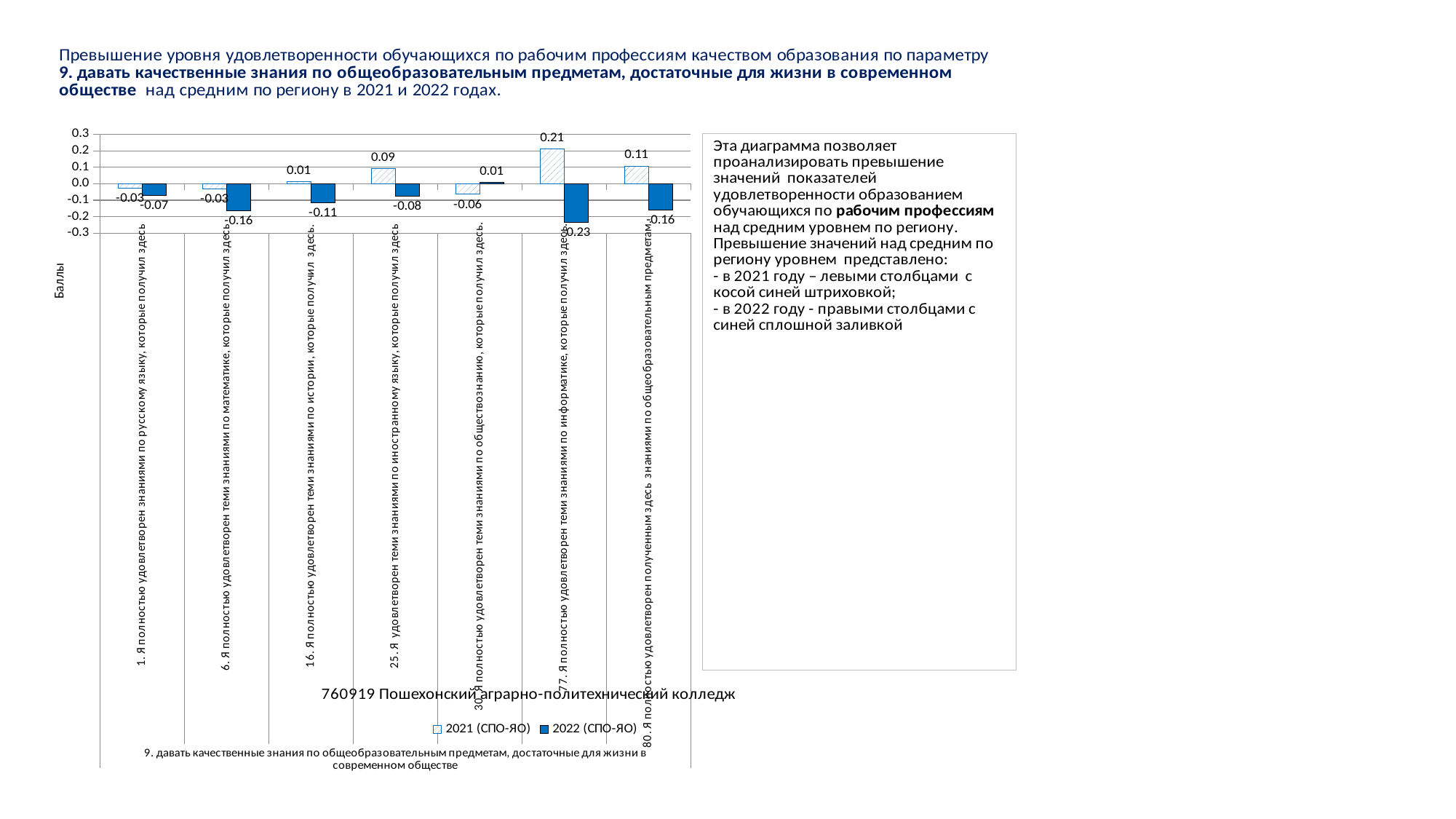
What is the 2022 (СПО-ЯО) value for category 30 (знания по обществознанию)? 0.01 How many categories are plotted on the x axis? 7 What is the label of the y axis? Баллы What is the difference between the 2021 and 2022 values for category 25 (знания по иностранному языку)? 0.17 Which category has the highest 2021 (СПО-ЯО) value? 77. Я полностью удовлетворен теми знаниями по информатике What is the 2021 (СПО-ЯО) value for category 80 (знания по общеобразовательным предметам)? 0.11 What is the 2021 (СПО-ЯО) value for category 77 (знания по информатике)? 0.21 How many series does the legend list? 2 Which is larger for category 1 (знания по русскому языку): the 2021 value or the 2022 value? 2021 (СПО-ЯО) What type of chart is shown on the slide? bar chart Which category has the lowest 2022 (СПО-ЯО) value? 77. Я полностью удовлетворен теми знаниями по информатике What is the 2022 (СПО-ЯО) value for category 6 (знания по математике)? -0.16